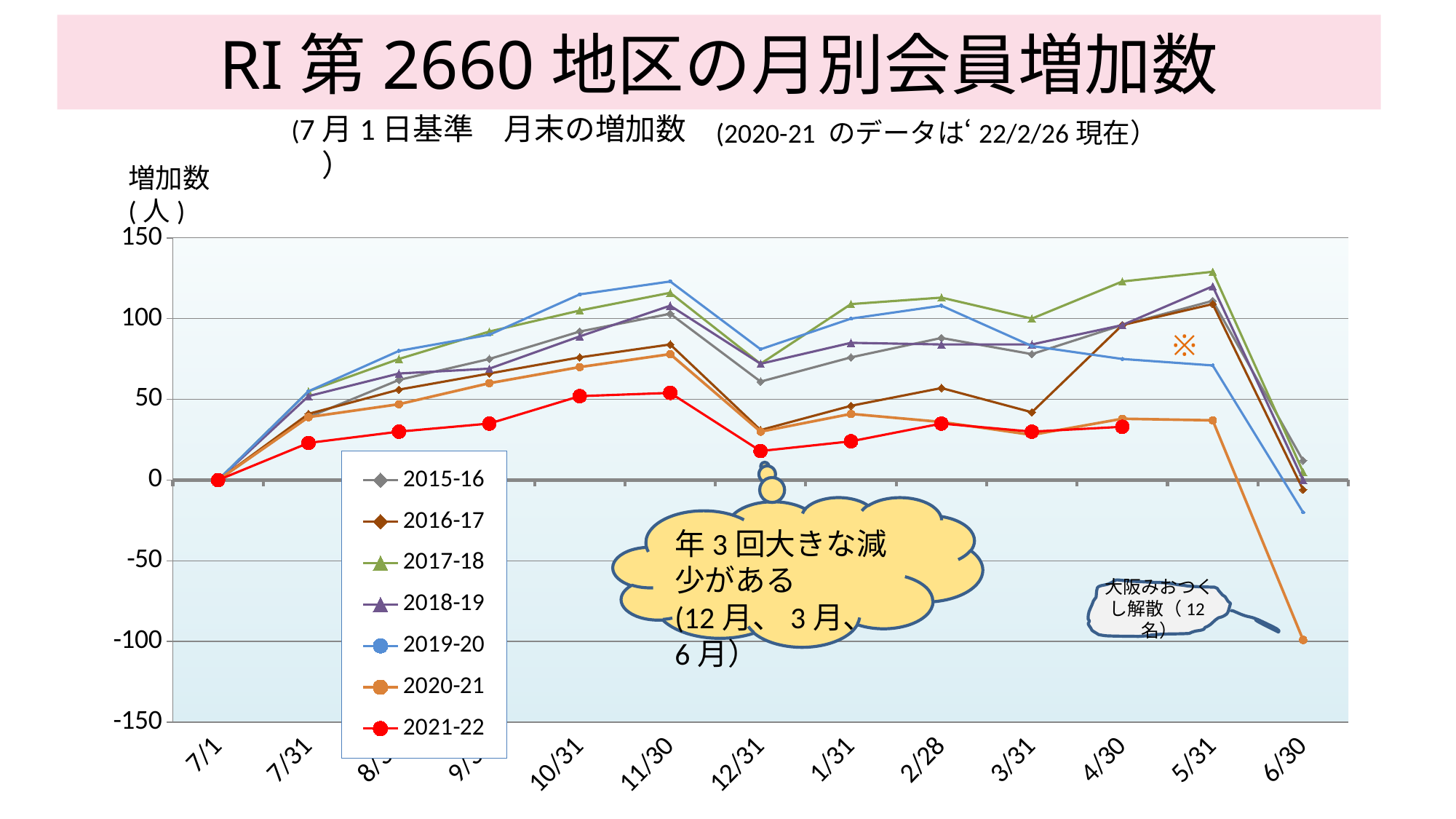
Is the value for the 2019-20 series at 6/30 greater or less than 0? less Is the value for the 2021-22 series at 12/31 greater or less than 50? less How many series does the legend list? 7 Which series has the lowest value at 11/30? 2021-22 Does the 2021-22 series rise or fall from 7/1 to 11/30? rise Which series has the highest value at 5/31? 2017-18 What kind of chart is shown on the slide? line chart What is the value for the 2021-22 series at 7/1? 0 At 10/31, which series has the larger value, 2019-20 or 2021-22? 2019-20 Is the value for the 2017-18 series at 5/31 greater or less than 100? greater Which series has the lowest value at 6/30? 2020-21 How many dates are shown along the x axis? 13